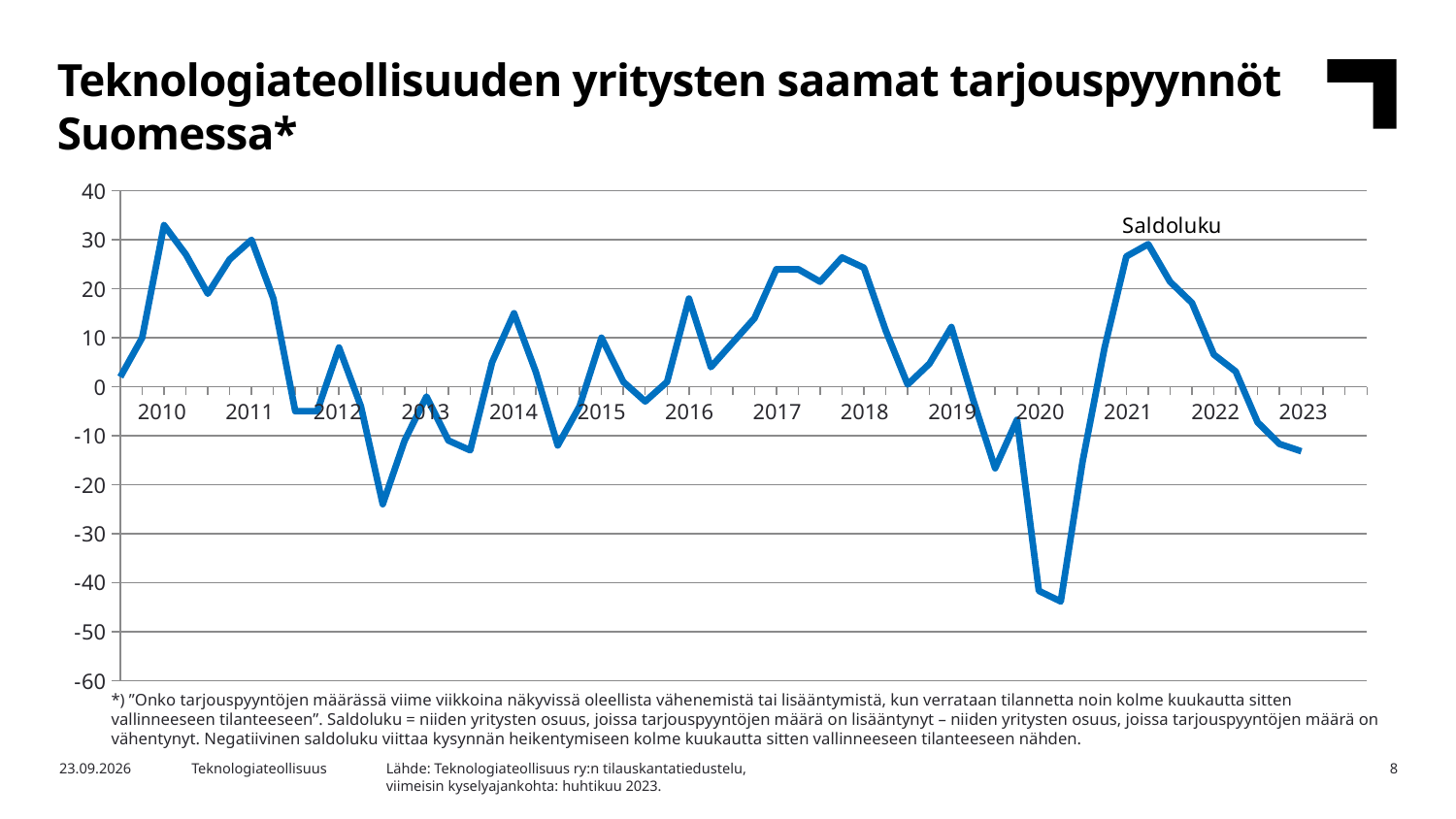
In which year does the line reach its lowest value? 2020 Is the peak value of the line in 2021 greater or less than 20? greater Does the line rise or fall from its 2021 peak to the end of 2023? fall What is the name of the series plotted on the chart? Saldoluku Is the lowest value of the line in 2020 greater or less than -40? less Is the value of the line at the end of 2023 greater or less than 0? less What is the title of the chart on the slide? Teknologiateollisuuden yritysten saamat tarjouspyynnöt Suomessa* What kind of chart is shown on the slide? line chart Does the line rise or fall from its 2020 low to its 2021 peak? rise How many year labels are shown on the x axis? 14